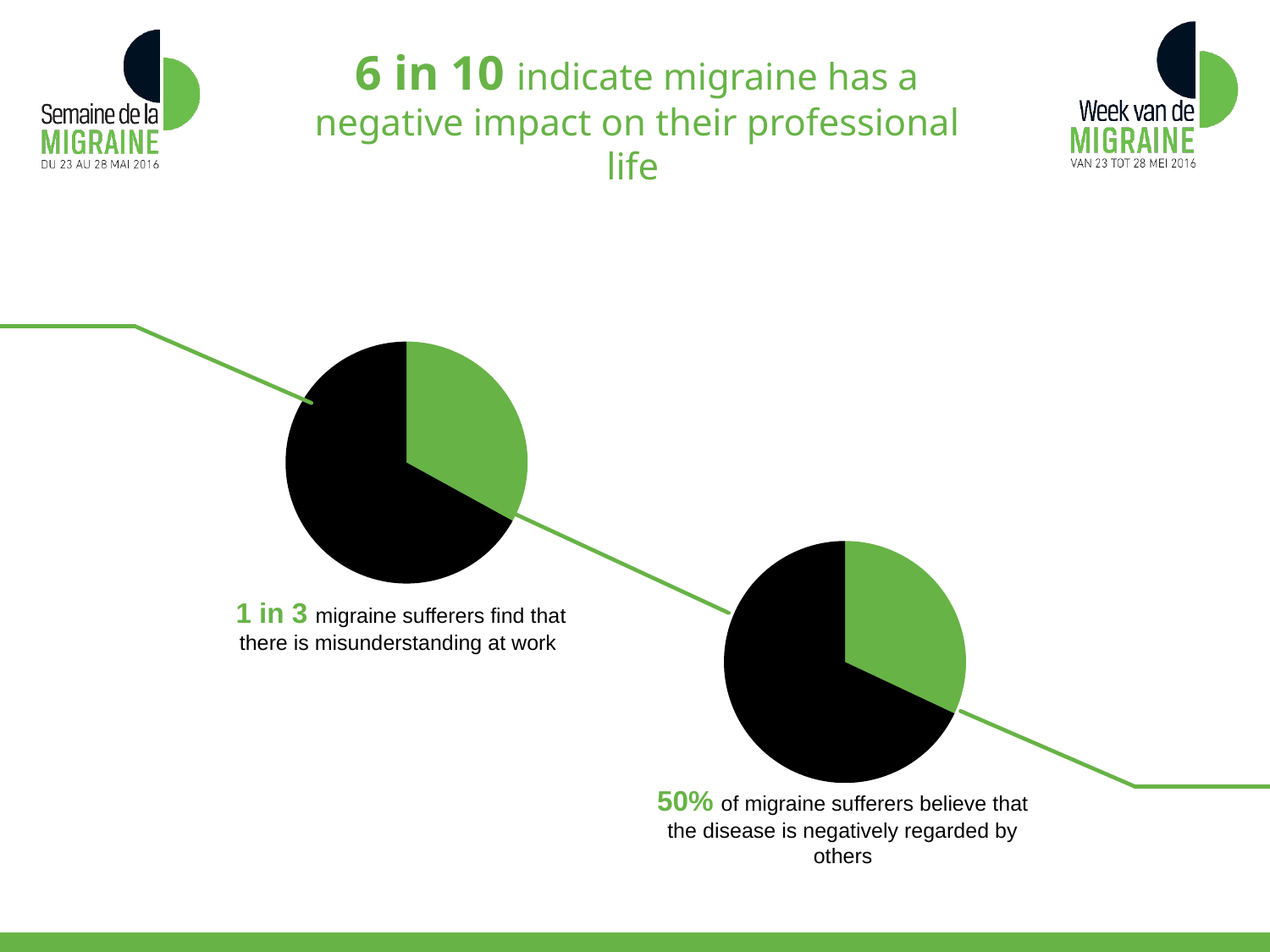
In the right pie chart, how many slices are there? 2 In the right pie chart, which slice is larger, the black one or the green one? black How many pie charts are on the slide? 2 In the left pie chart, which slice is larger, the black one or the green one? black What kind of chart is shown on the left of the slide? pie chart In the left pie chart, how many slices are there? 2 According to the caption under the right pie chart, what percentage of migraine sufferers believe the disease is negatively regarded by others? 50% According to the caption under the left pie chart, what fraction of migraine sufferers find that there is misunderstanding at work? 1 in 3